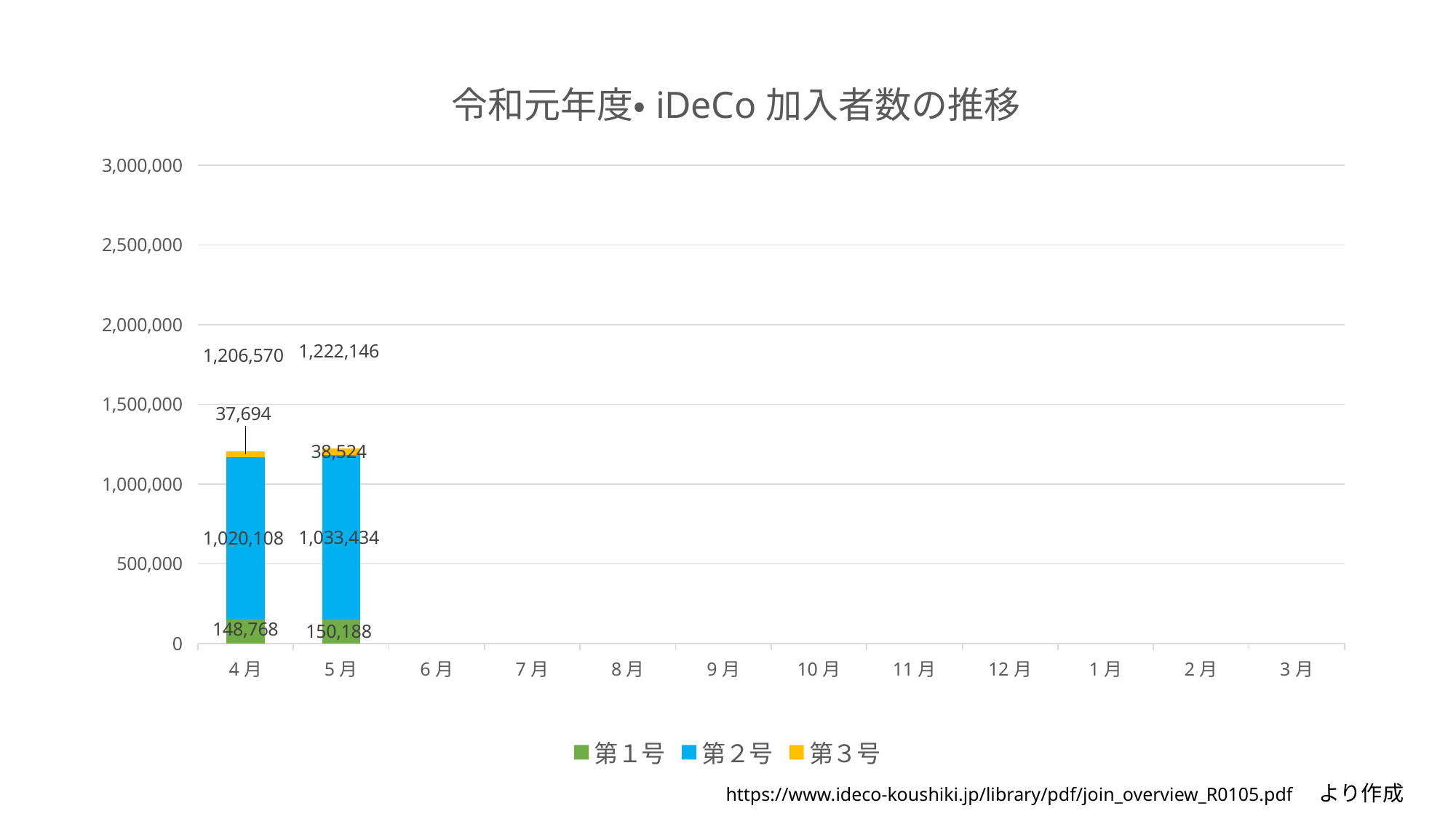
Is the total for 4月 greater or less than 1,500,000? less Which series has the highest value in 4月? 第２号 How many series does the legend list? 3 What is the title of the chart? 令和元年度• iDeCo 加入者数の推移 What is the value for 第２号 in 4月? 1,020,108 What is the difference between the 第２号 values for 5月 and 4月? 13,326 Which is larger, the 第３号 value for 4月 or for 5月? 5月 What type of chart is shown on the slide? stacked bar chart What is the total of the stacked bar for 5月? 1,222,146 What is the value for 第３号 in 4月? 37,694 What is the value for 第１号 in 5月? 150,188 How many month categories are shown on the x axis? 12